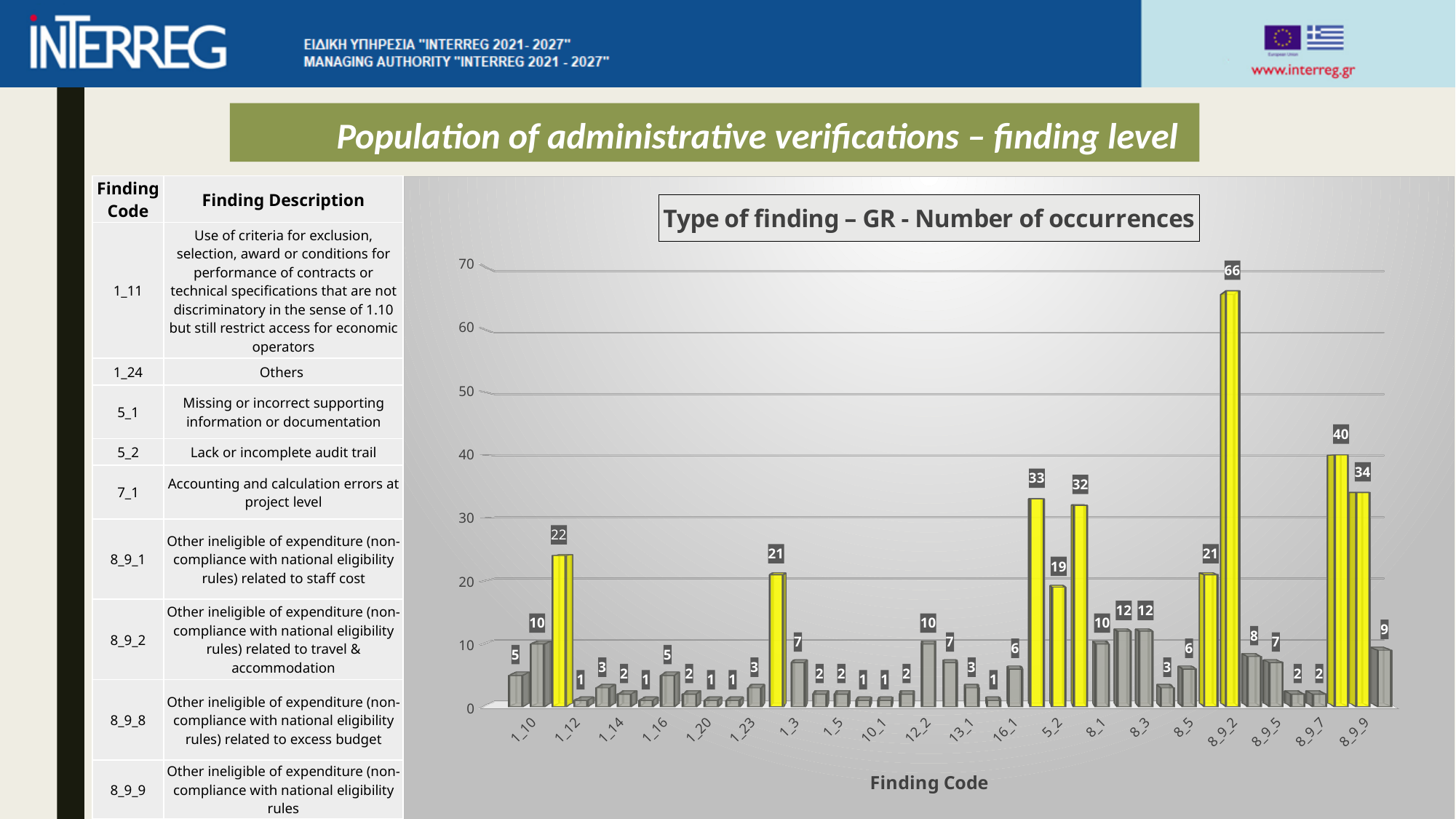
What is the highest number of occurrences shown by any bar in the chart? 66 How many bars in the chart have a value greater than 30? 5 How many bars in the chart are highlighted in yellow? 9 What is the title of the chart? Type of finding – GR - Number of occurrences What type of chart is shown on the slide? bar chart What is the difference between the highest bar (66) and the second-highest bar (40)? 26 Which is larger, the bar labelled 33 or the bar labelled 32? 33 What is the lowest number of occurrences shown by any bar in the chart? 1 What is the highest value marked on the vertical axis of the chart? 70 What is the x-axis title of the chart? Finding Code Is the tallest bar in the chart greater or less than 60? greater What is the second-highest value shown in the chart? 40